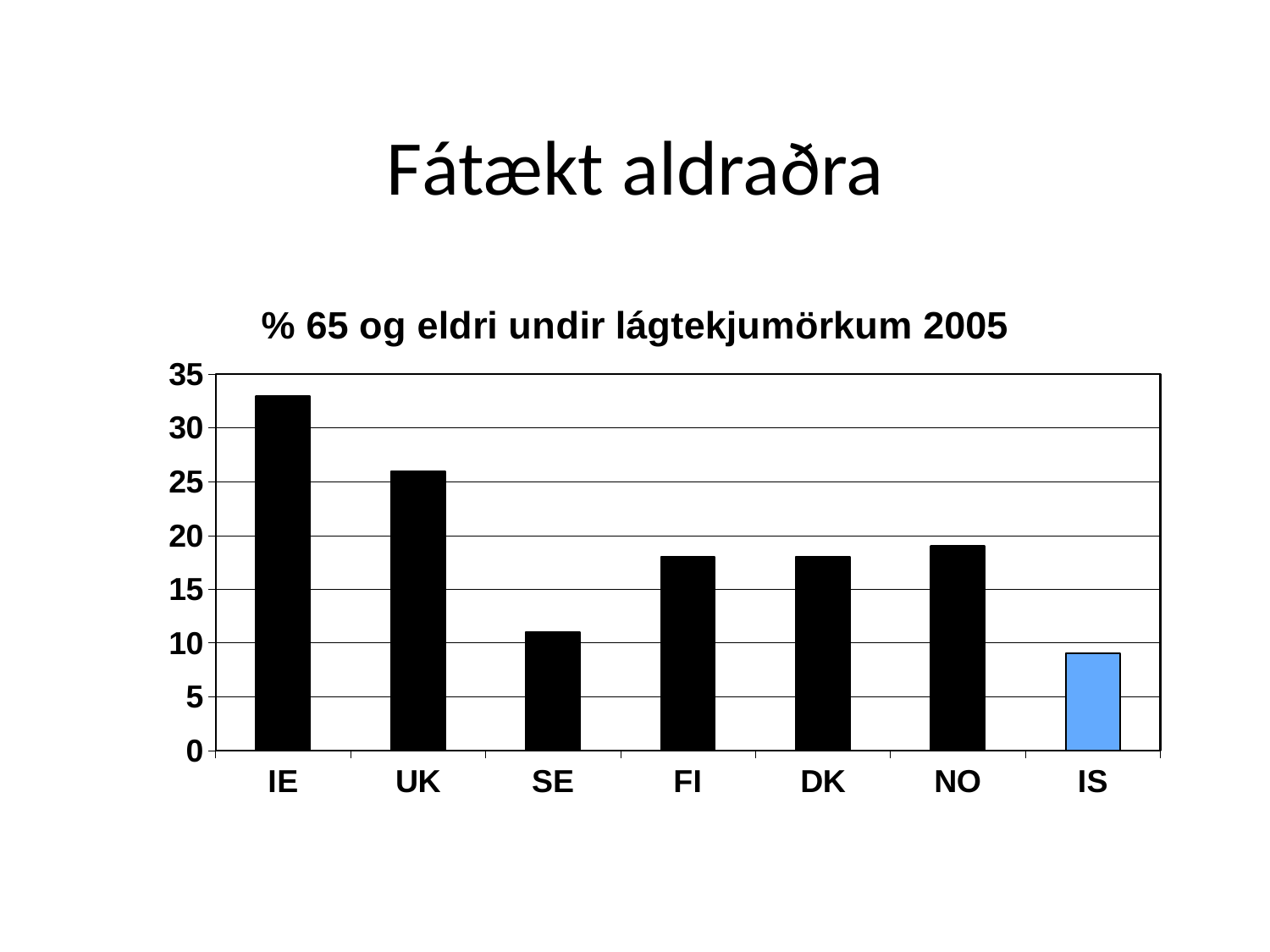
Which country has the highest value in the chart? IE Is the value for IS greater or less than 10? less Which bar is drawn in a different colour (blue) from the others? IS Which country has the lowest value in the chart? IS How many countries are shown on the x axis of the chart? 7 What is the title of the chart? % 65 og eldri undir lágtekjumörkum 2005 Which has the larger value, UK or SE? UK Is the value for IE greater or less than 30? greater Is the value for UK greater or less than 25? greater What kind of chart is shown on the slide? bar chart